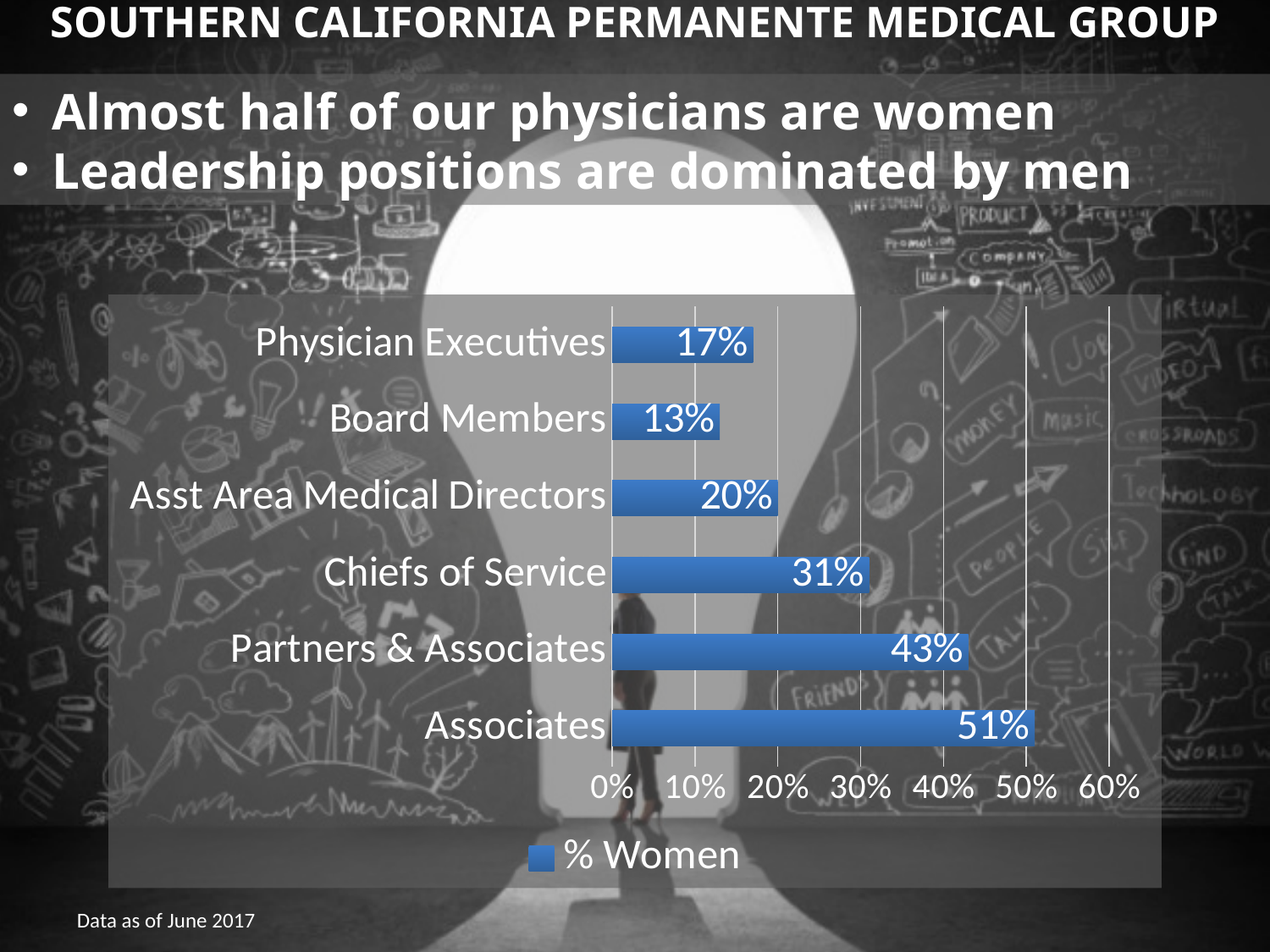
Which has a higher % Women, Asst Area Medical Directors or Chiefs of Service? Chiefs of Service What is the % Women value for Physician Executives? 17% What is the difference in % Women between Associates and Physician Executives? 34% What series name does the legend show? % Women What is the % Women value for Board Members? 13% Which category has the lowest % Women? Board Members Which category has the highest % Women? Associates How many categories are shown in the chart? 6 What kind of chart is shown on the slide? Bar chart Is the % Women value for Associates greater or less than 50%? greater What is the % Women value for Partners & Associates? 43% What is the % Women value for Chiefs of Service? 31%